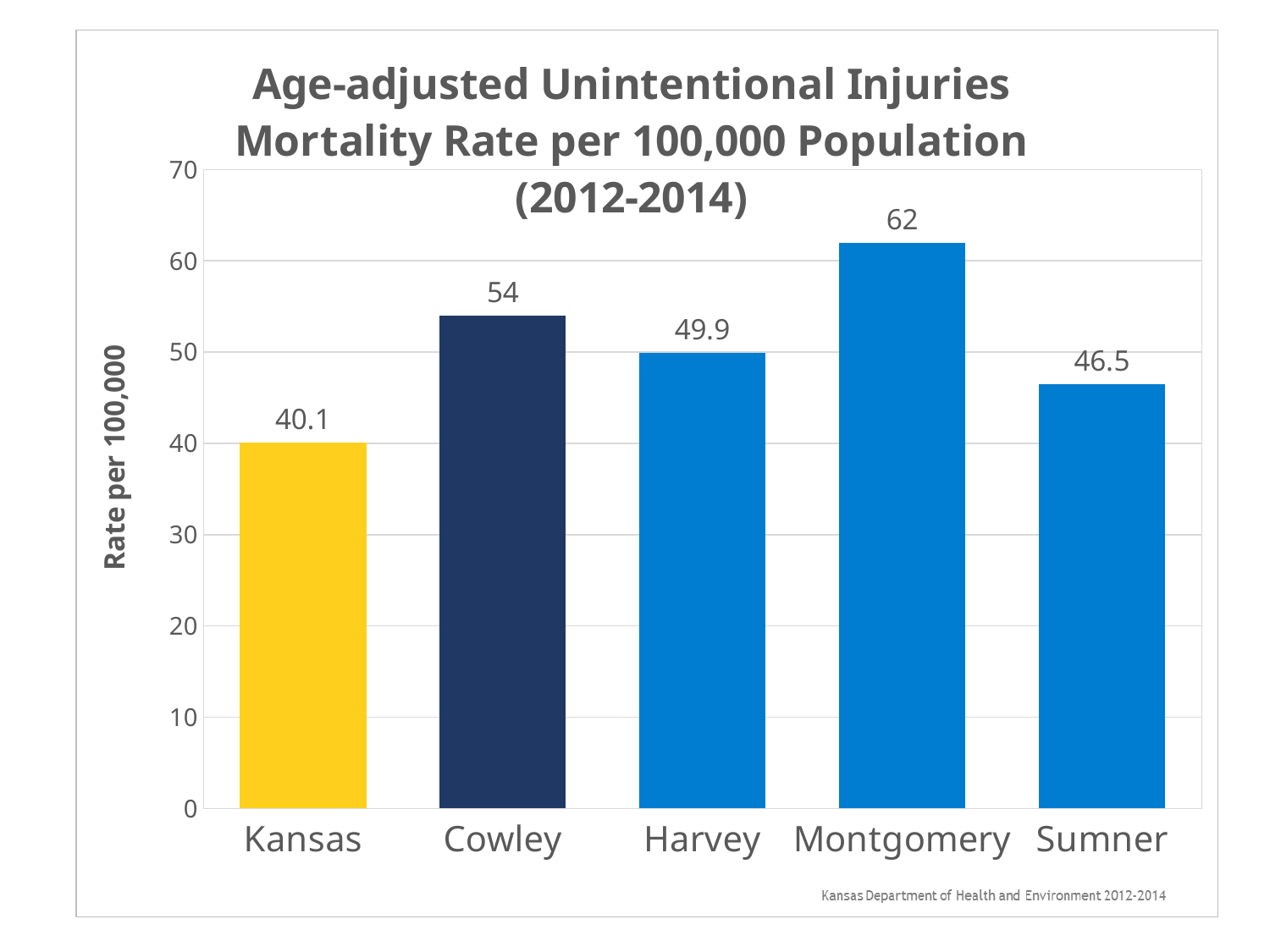
What kind of chart is shown on the slide? Bar chart Which has a higher mortality rate, Cowley or Harvey? Cowley Which category has the highest mortality rate? Montgomery How many categories are shown on the x axis? 5 Is the value for Sumner greater or less than 50? less What is the difference between the mortality rates for Montgomery and Kansas? 21.9 What is the mortality rate shown for Harvey? 49.9 Which category has the lowest mortality rate? Kansas What is the difference between the mortality rates for Cowley and Sumner? 7.5 What is the label of the vertical axis? Rate per 100,000 What is the age-adjusted unintentional injuries mortality rate for Kansas? 40.1 What is the mortality rate shown for Montgomery? 62